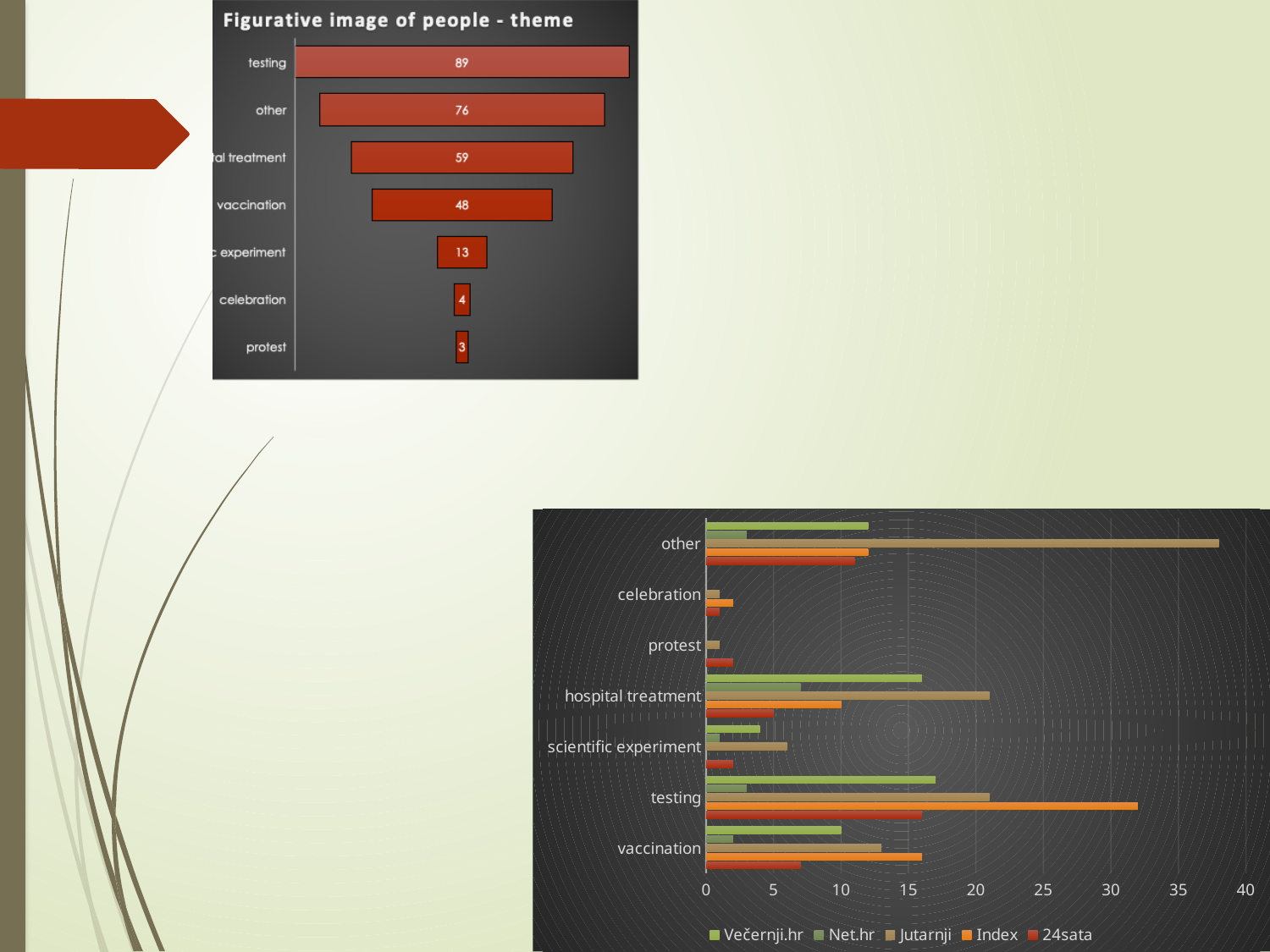
In the chart titled 'Figurative image of people - theme', which category has the highest value? testing In the chart titled 'Figurative image of people - theme', which is larger, the value for vaccination or the value for celebration? vaccination In the chart at the bottom right of the slide, how many series does the legend list? 5 In the chart titled 'Figurative image of people - theme', how many categories are shown? 7 In the chart titled 'Figurative image of people - theme', what is the value for vaccination? 48 In the chart titled 'Figurative image of people - theme', what is the value for protest? 3 What kind of chart is shown at the bottom right of the slide? bar chart In the chart at the bottom right of the slide, is the Jutarnji value for 'other' greater or less than 35? greater In the chart titled 'Figurative image of people - theme', what is the value for testing? 89 In the chart titled 'Figurative image of people - theme', which category has the lowest value? protest In the chart titled 'Figurative image of people - theme', what is the difference between the values for testing and other? 13 In the chart at the bottom right of the slide, is the Index value for 'testing' greater or less than 30? greater